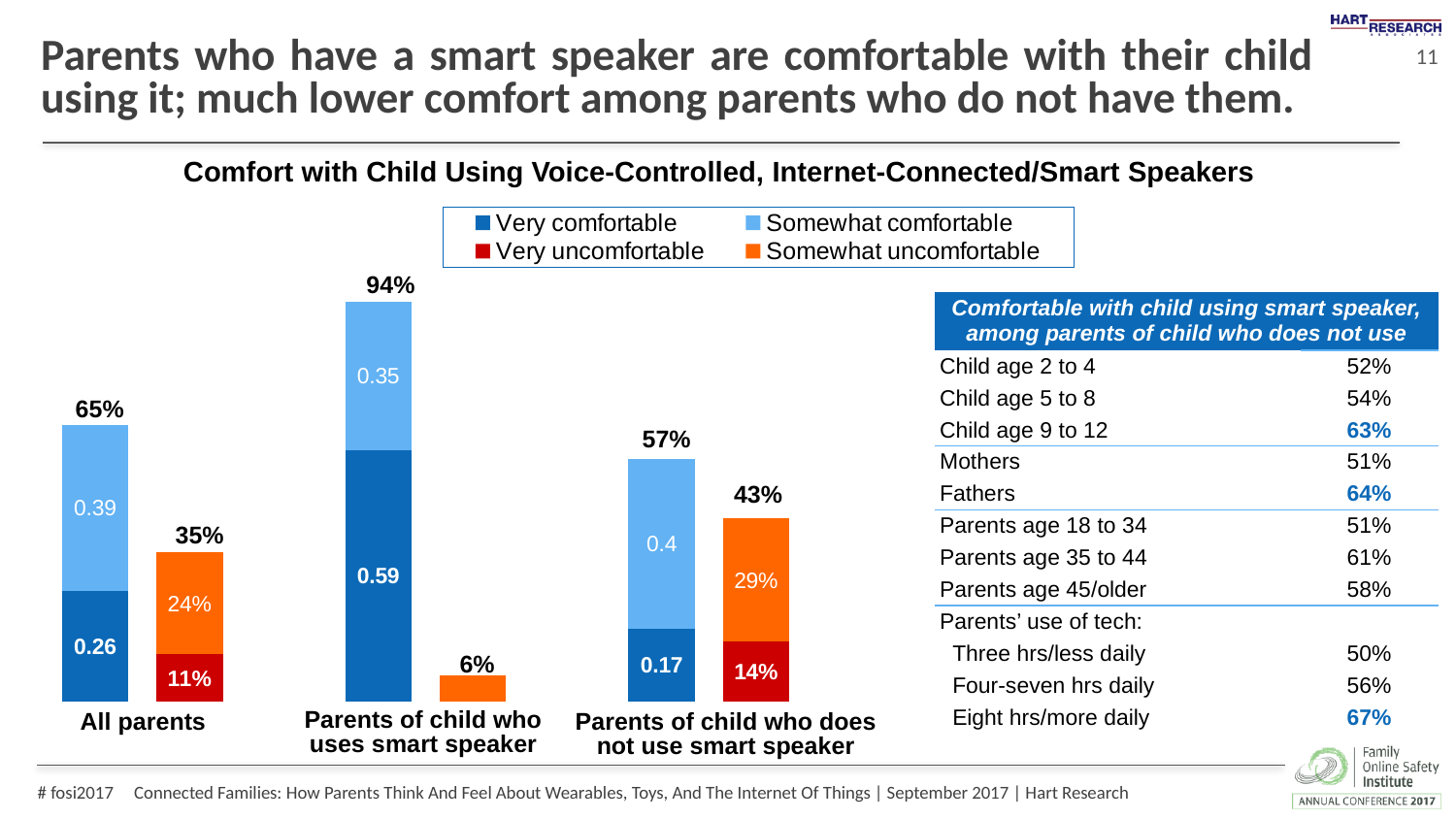
What is the difference between the total comfortable share for parents of a child who uses a smart speaker and for parents of a child who does not? 37% What kind of chart is shown on the slide? Stacked bar chart What is the 'Very comfortable' value for all parents? 0.26 What is the 'Somewhat comfortable' value for parents of a child who uses a smart speaker? 0.35 What is the 'Very uncomfortable' value for parents of a child who does not use a smart speaker? 14% Which parent group has the lowest total uncomfortable share? Parents of child who uses smart speaker Which is larger for all parents: the 'Somewhat uncomfortable' value or the 'Very uncomfortable' value? Somewhat uncomfortable What is the total comfortable share (very plus somewhat) for parents of a child who uses a smart speaker? 94% What is the title of the chart? Comfort with Child Using Voice-Controlled, Internet-Connected/Smart Speakers How many series does the chart legend list? 4 Which parent group has the highest total comfortable share? Parents of child who uses smart speaker What is the total uncomfortable share for parents of a child who does not use a smart speaker? 43%